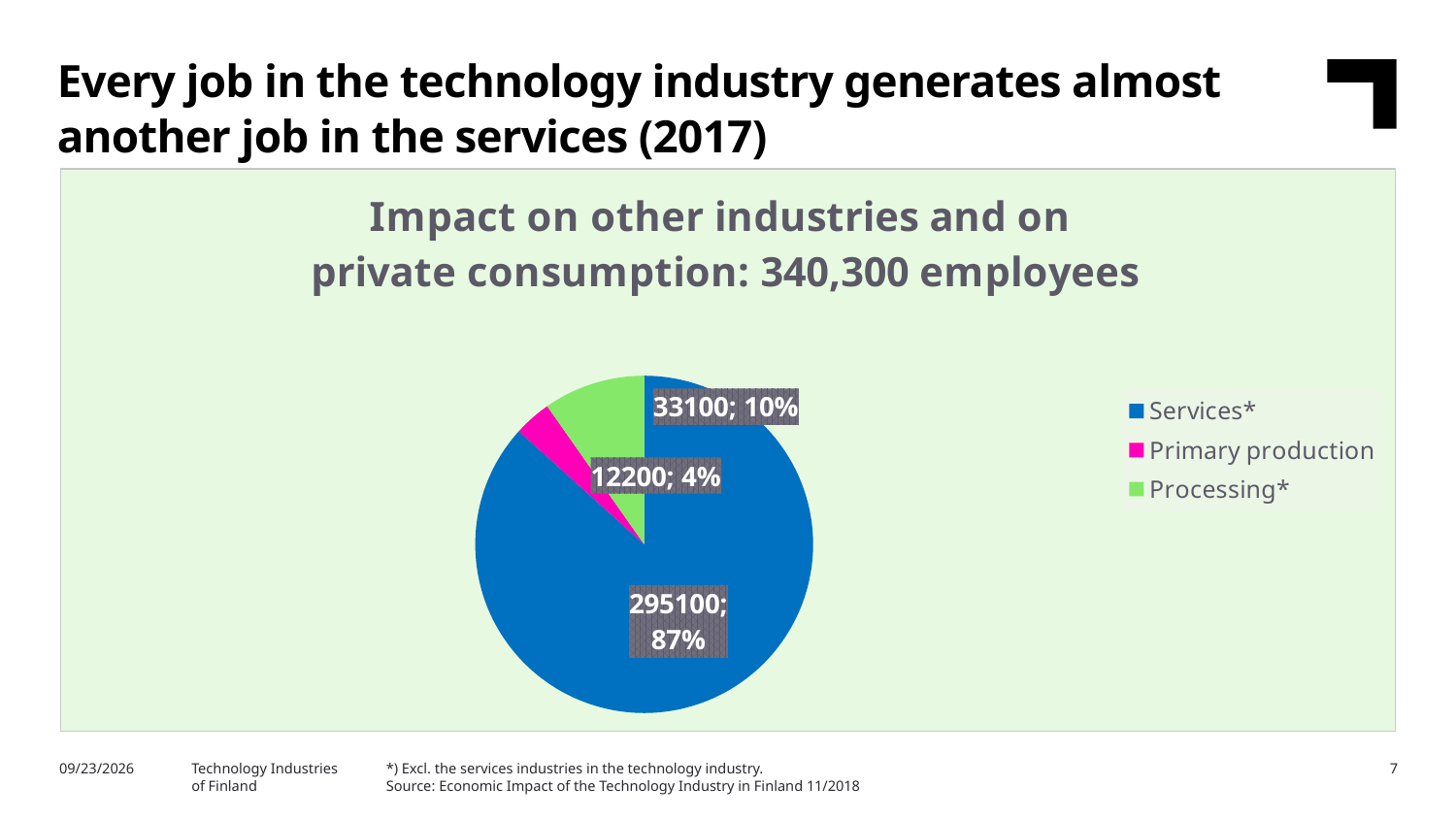
Which category has the largest slice of the pie? Services* What is the value for Primary production in the pie chart? 12200 What is the title of the chart? Impact on other industries and on private consumption: 340,300 employees What type of chart is shown on the slide? Pie chart What is the difference between the values for Processing* and Primary production? 20900 What share of the pie does Processing* represent? 10% What is the value for Services* in the pie chart? 295100 What share of the pie does Services* represent? 87% How many entries does the legend list? 3 What is the value for Processing* in the pie chart? 33100 How many slices does the pie chart have? 3 Which category has the smallest slice of the pie? Primary production